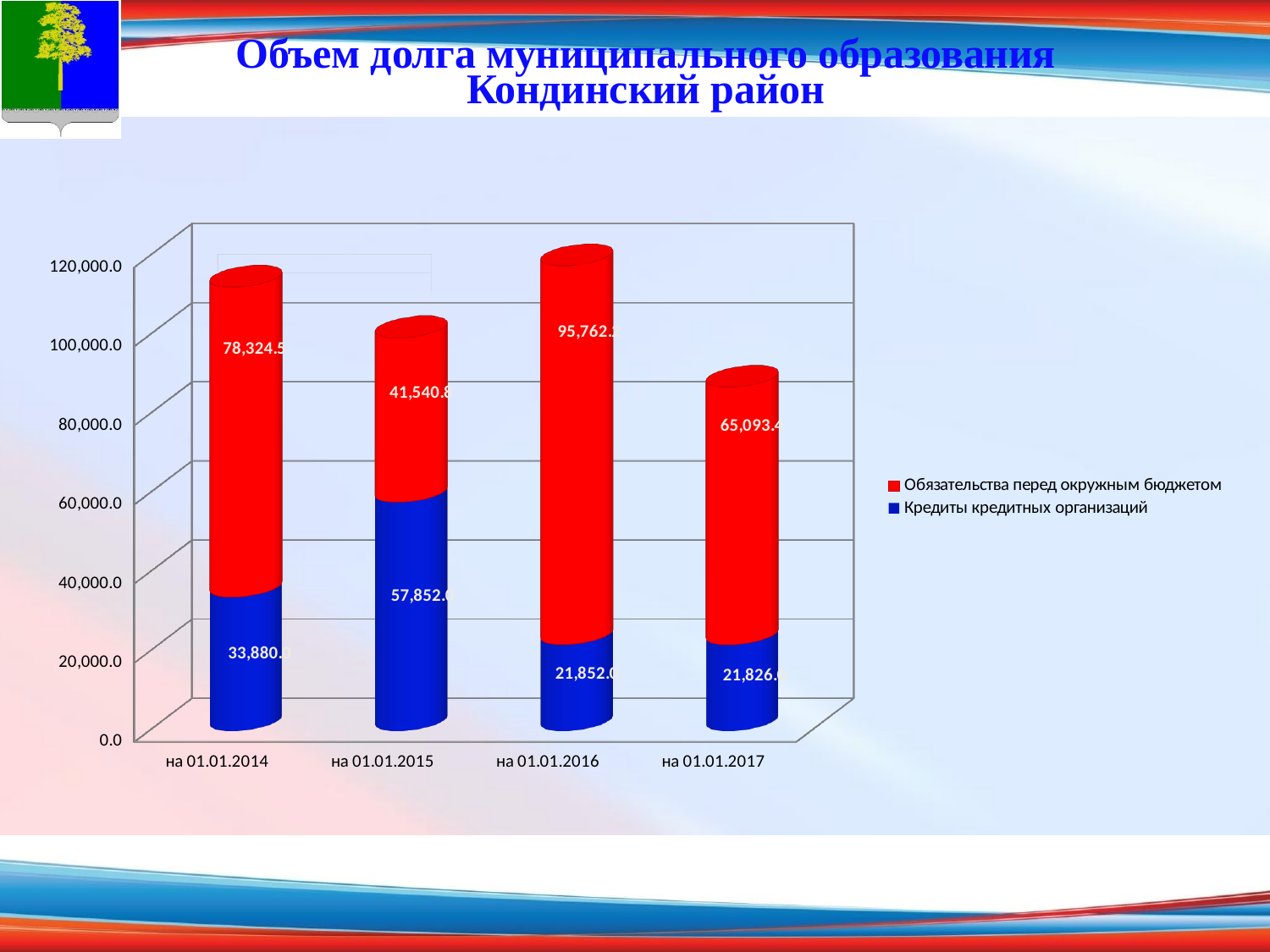
On which date is 'Кредиты кредитных организаций' the highest? на 01.01.2015 What is the value of 'Обязательства перед окружным бюджетом' на 01.01.2014? 78,324.5 What is the value of 'Обязательства перед окружным бюджетом' на 01.01.2017? 65,093.4 Is the total stacked bar на 01.01.2016 greater or less than 100,000.0? greater What kind of chart is shown on the slide? bar chart How many dates (categories) are shown on the x axis? 4 What is the value of 'Обязательства перед окружным бюджетом' на 01.01.2015? 41,540.8 What is the difference between 'Обязательства перед окружным бюджетом' на 01.01.2014 and на 01.01.2015? 36,783.7 On which date is 'Обязательства перед окружным бюджетом' the lowest? на 01.01.2015 Which colour represents 'Кредиты кредитных организаций' in the chart? blue On which date is 'Обязательства перед окружным бюджетом' the highest? на 01.01.2016 How many series does the legend list? 2